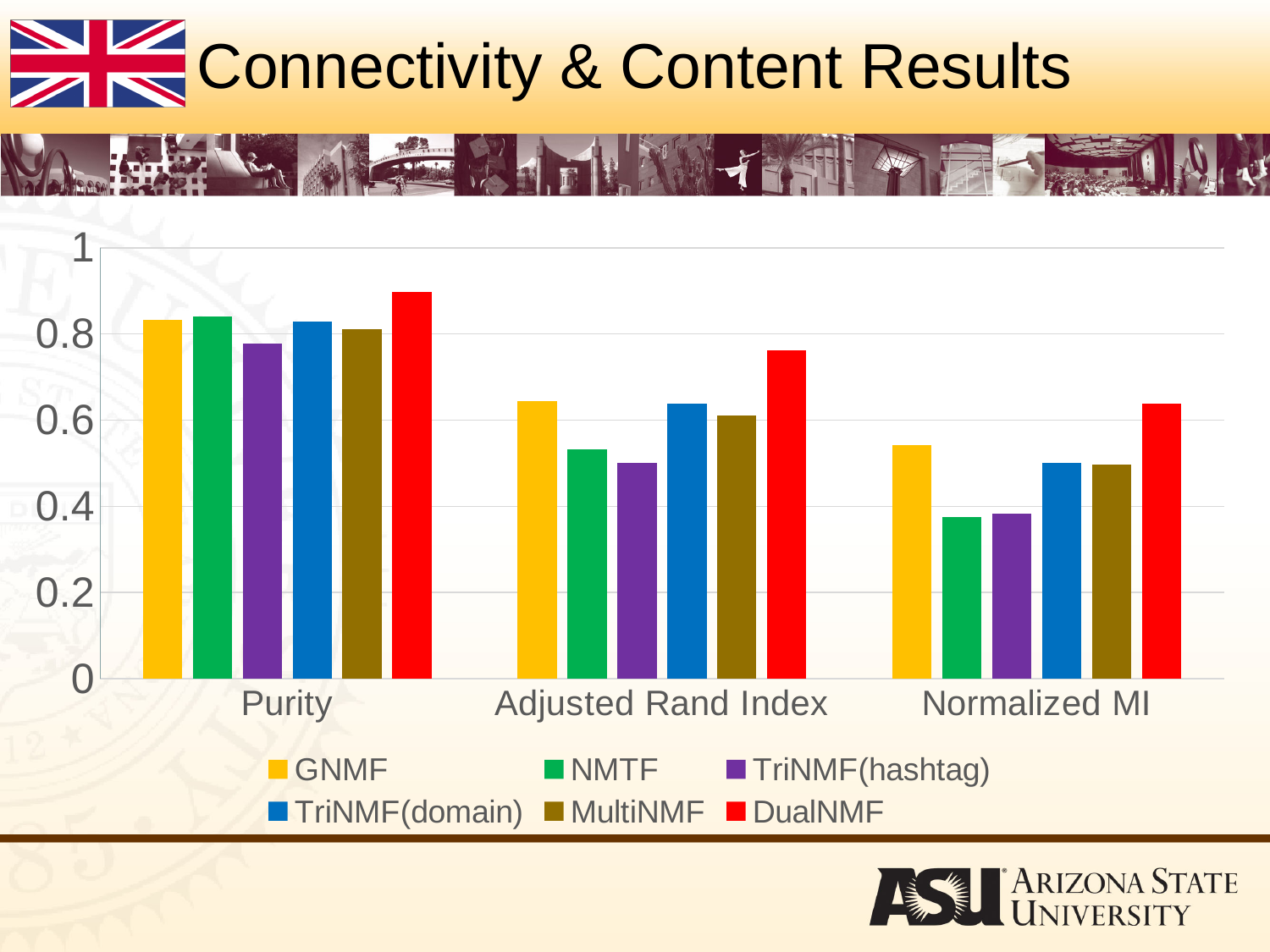
Which method has the highest Purity value? DualNMF What colour represents DualNMF in the chart's legend? red Which method has the highest Adjusted Rand Index value? DualNMF What kind of chart is shown on the slide? bar chart For Adjusted Rand Index, which is larger: the value for DualNMF or the value for MultiNMF? DualNMF Is the Normalized MI value for NMTF greater or less than 0.4? less Is the Purity value for DualNMF greater or less than 0.8? greater Which method has the lowest Purity value? TriNMF(hashtag) How many series does the chart's legend list? 6 For Normalized MI, which is larger: the value for GNMF or the value for NMTF? GNMF How many categories are shown along the x axis of the chart? 3 Is the Adjusted Rand Index value for GNMF greater or less than 0.6? greater